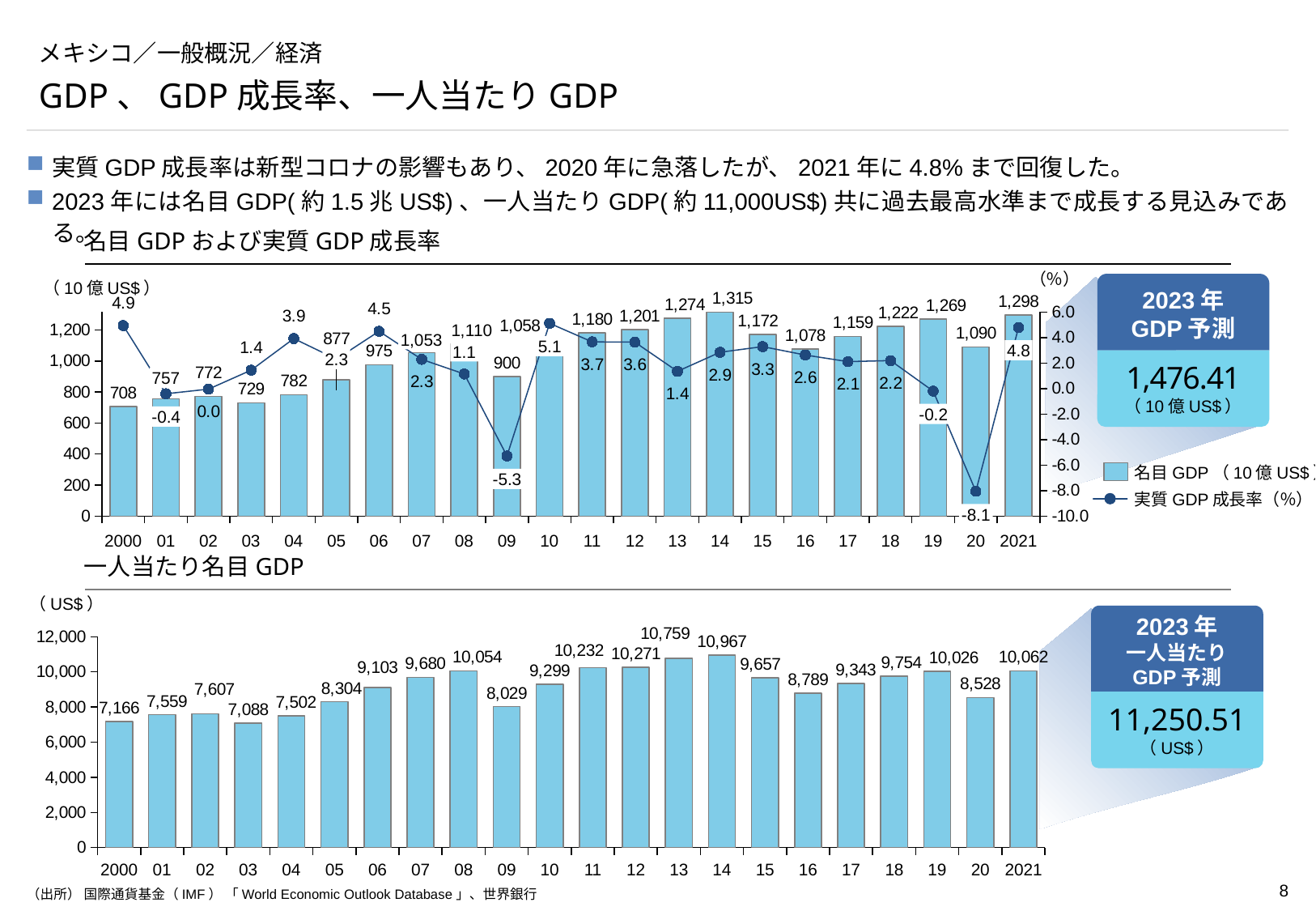
In the top chart (名目GDPおよび実質GDP成長率), what is the real GDP growth rate for 2020? -8.1 In the top chart (名目GDPおよび実質GDP成長率), which year has the lowest real GDP growth rate? 2020 In the bottom chart (一人当たり名目GDP), which year has the highest value? 2014 In the top chart (名目GDPおよび実質GDP成長率), how many series does the legend list? 2 In the top chart (名目GDPおよび実質GDP成長率), what is the difference between the nominal GDP of 2021 and 2020? 208 In the top chart (名目GDPおよび実質GDP成長率), what is the nominal GDP value for 2014? 1,315 In the bottom chart (一人当たり名目GDP), what is the difference between the values for 2021 and 2020? 1,534 In the top chart (名目GDPおよび実質GDP成長率), which year has the highest nominal GDP bar? 2014 In the bottom chart (一人当たり名目GDP), which year has the lowest value? 2003 In the bottom chart (一人当たり名目GDP), what is the value for 2013? 10,759 What kind of chart is the bottom chart (一人当たり名目GDP)? bar chart In the top chart (名目GDPおよび実質GDP成長率), is the nominal GDP for 2009 larger or smaller than that for 2008? smaller